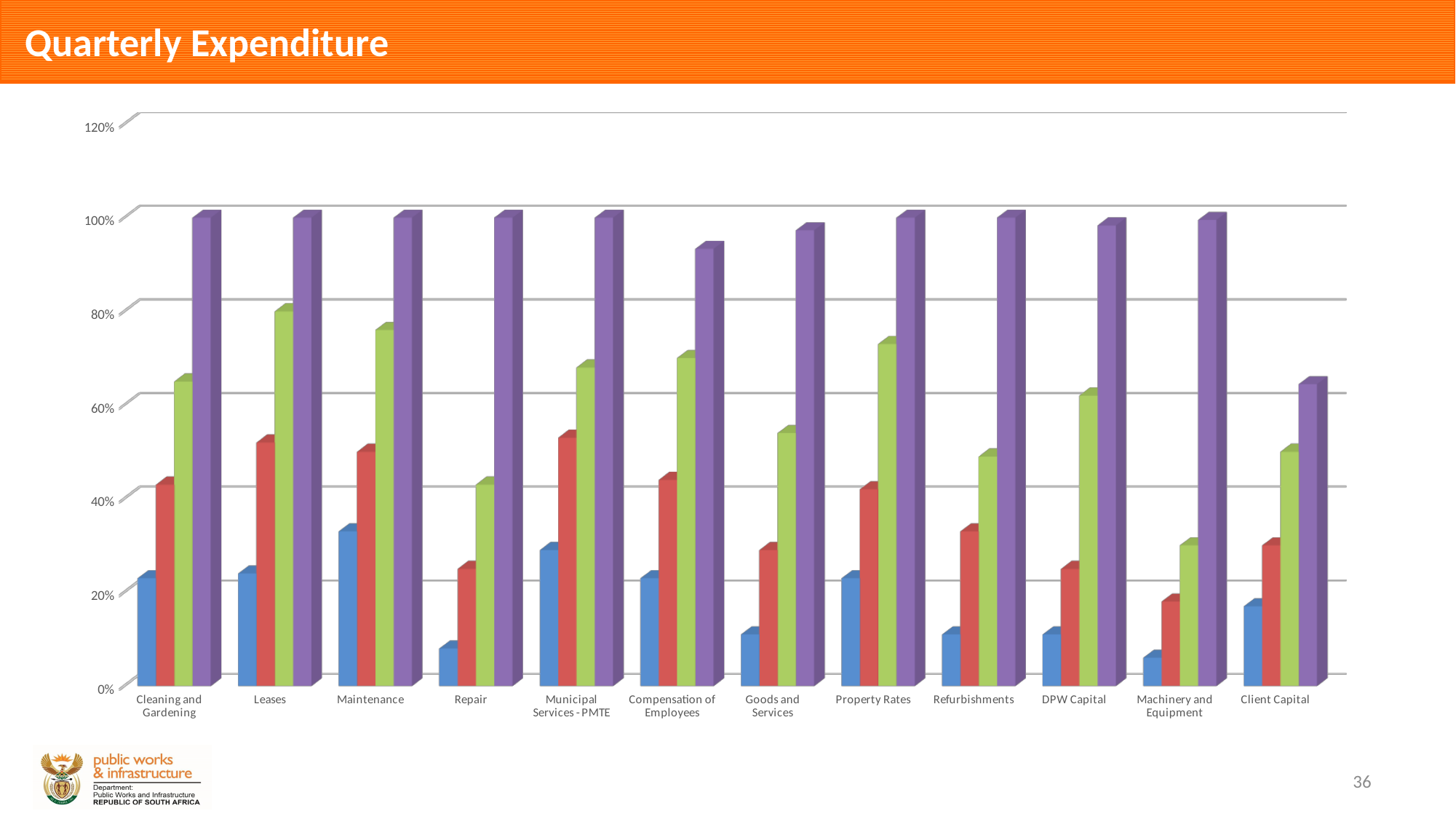
Is the value of the blue bar for Maintenance greater or less than 20%? greater Which category has the lowest purple bar? Client Capital Is the value of the purple bar for Client Capital greater or less than 80%? less Is the value of the green bar for Property Rates greater or less than 60%? greater How many categories are shown along the x axis of the chart? 12 Which category has the lowest green bar? Machinery and Equipment What kind of chart is shown on the slide? bar chart Which is larger, the green bar for Leases or the green bar for Client Capital? Leases What is the title of the slide containing the chart? Quarterly Expenditure How many bars are plotted for each category in the chart? 4